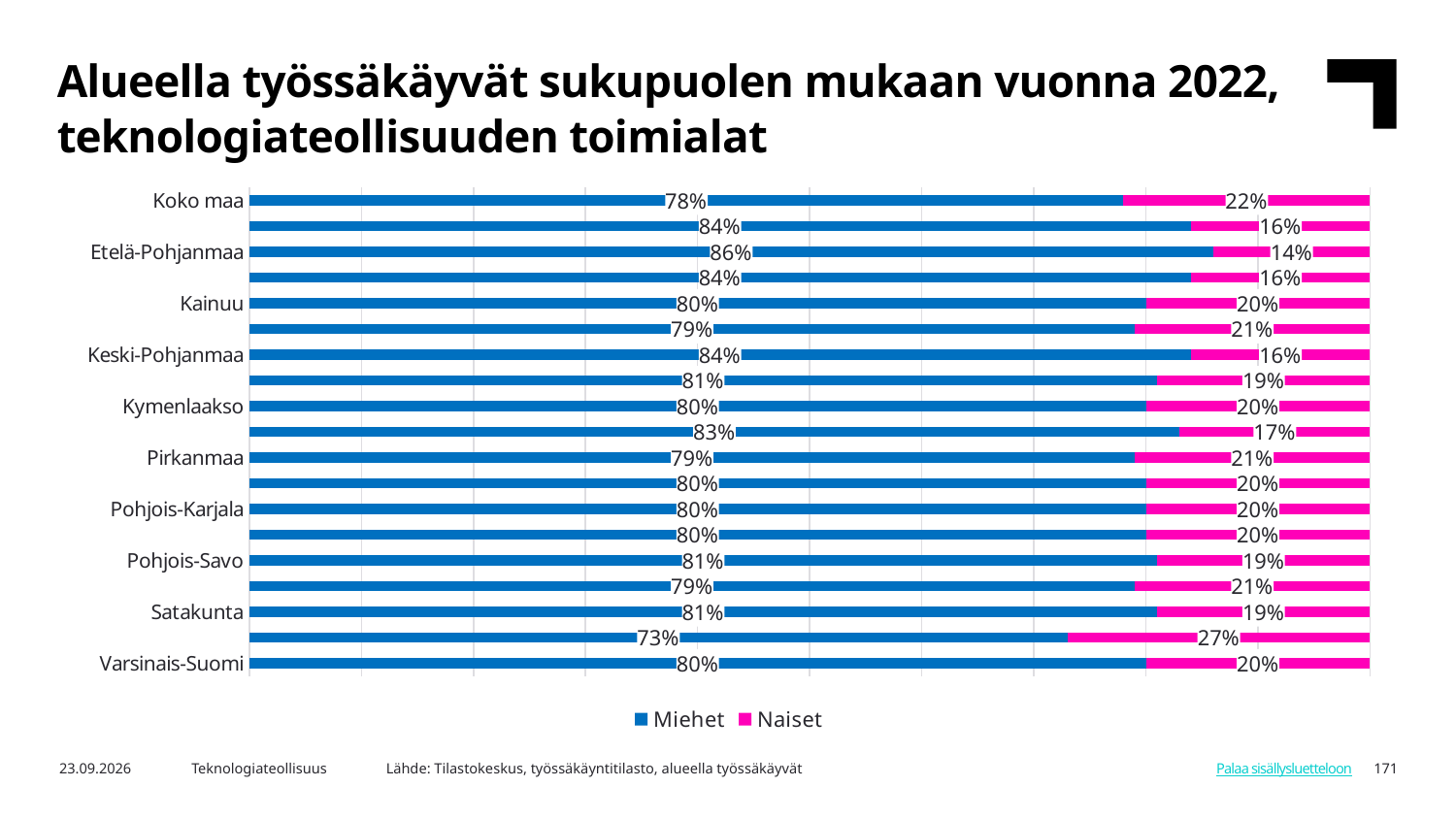
Which region has the lowest Naiset share? Etelä-Pohjanmaa Which region has the highest Miehet share? Etelä-Pohjanmaa What is the difference between the Miehet and Naiset shares for Koko maa? 56 percentage points What are the two legend entries of the chart? Miehet and Naiset What is the Naiset share for Etelä-Pohjanmaa? 14% Which is larger, the Miehet share for Keski-Pohjanmaa or for Kainuu? Keski-Pohjanmaa What kind of chart is shown on the slide? Stacked bar chart How many series does the legend list? 2 What is the Miehet share for Pohjois-Savo? 81% What is the Miehet share for Koko maa? 78% What is the total of the stacked bar for Varsinais-Suomi? 100% What is the Naiset share for Pirkanmaa? 21%